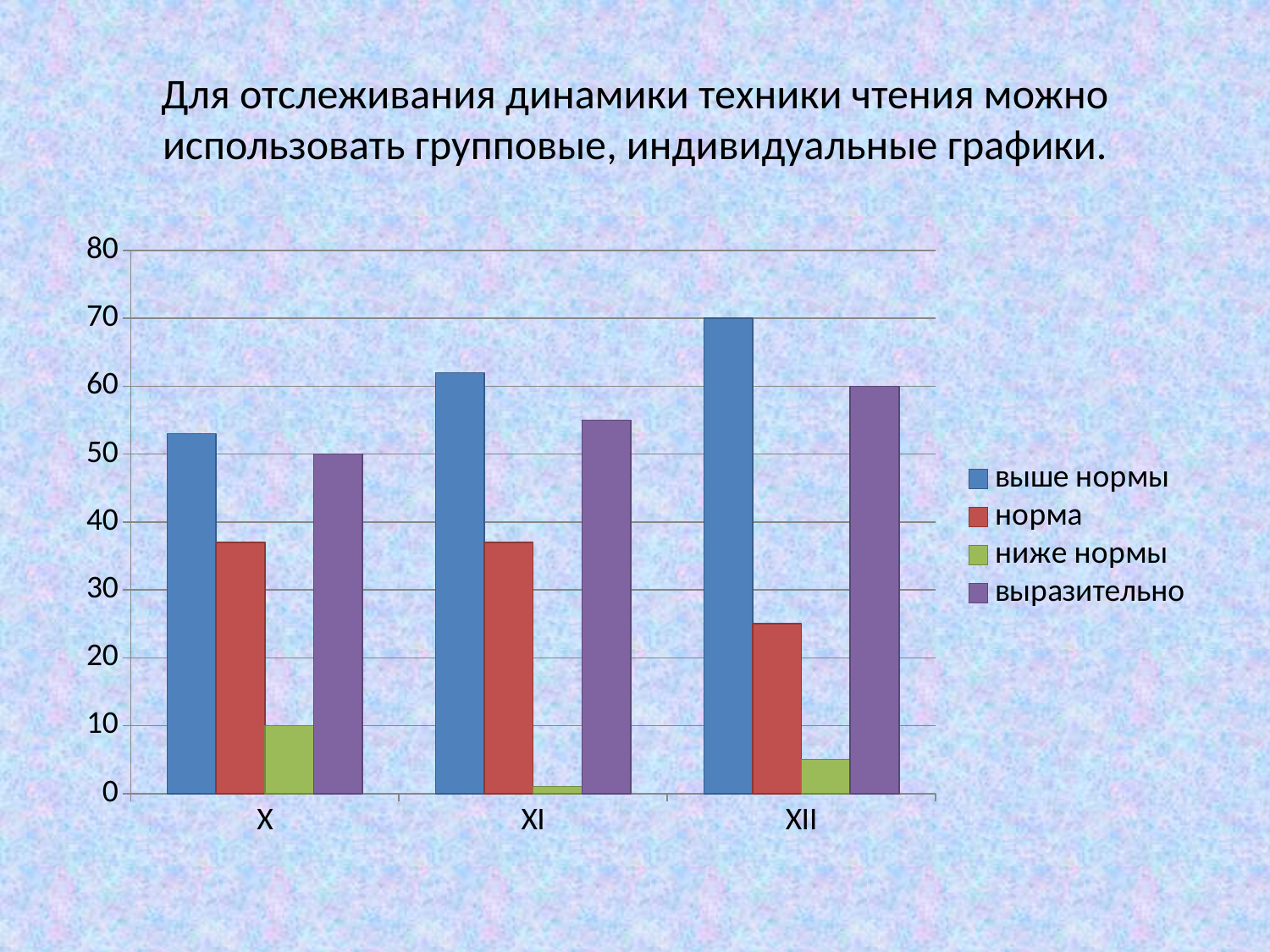
In which category is the "выше нормы" series highest? XII What is the value for "ниже нормы" in category X? 10 Is the value for "выше нормы" in category XI greater or less than 60? greater How many categories are shown on the x axis? 3 What is the value for "выше нормы" in category XII? 70 How many series does the legend list? 4 Does the "выше нормы" series rise or fall from X to XII? rise What is the value for "выразительно" in category XII? 60 Is the value for "норма" in category XII greater or less than 30? less In which category is the "ниже нормы" series lowest? XI What kind of chart is shown on the slide? bar chart What is the value for "выразительно" in category X? 50